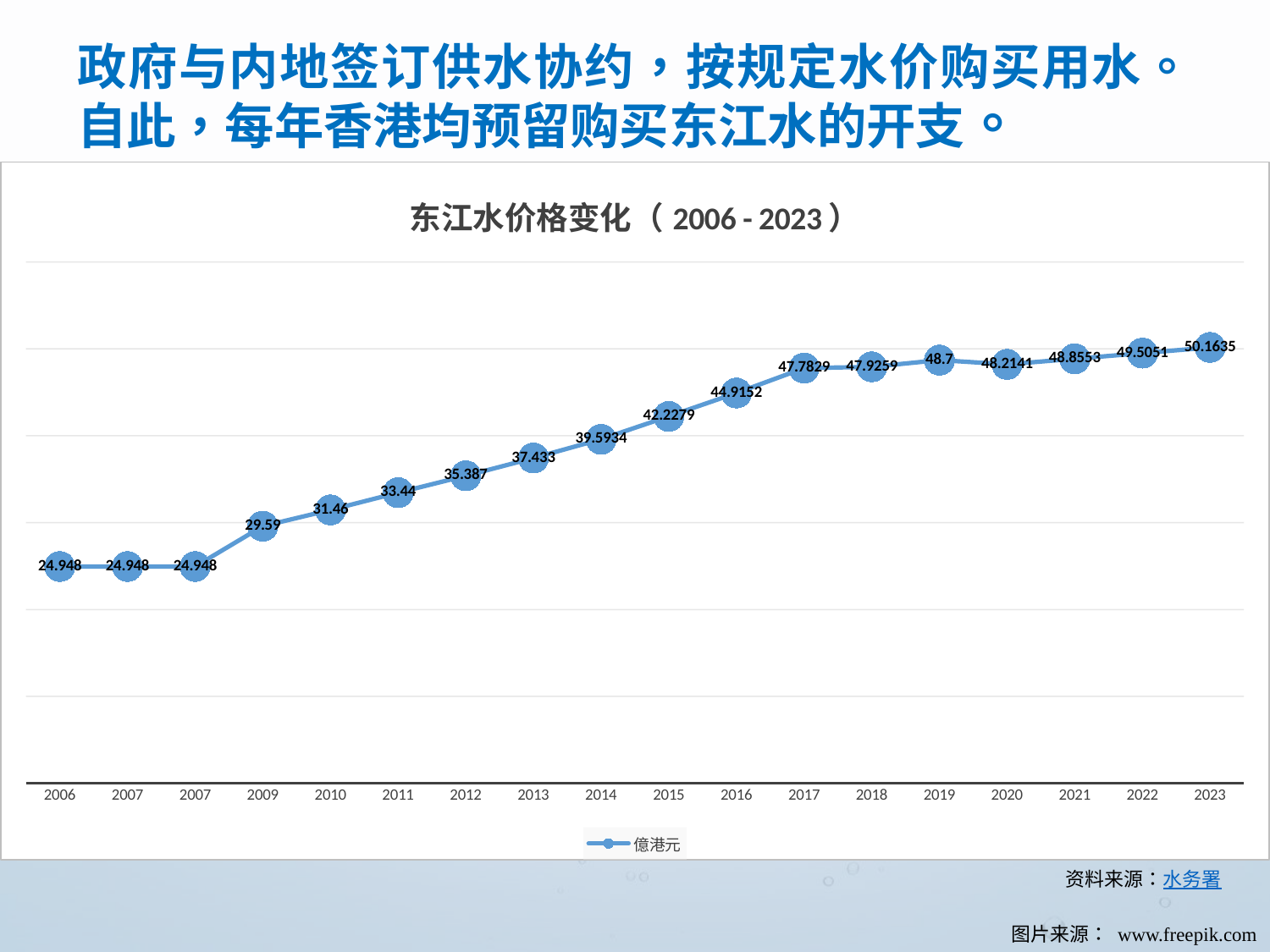
How many series does the legend list? 1 What type of chart is shown on the slide? line chart Do the values generally rise or fall from 2006 to 2023? rise What is the difference between the values for 2023 and 2006? 25.2155 What is the value for 2019? 48.7 What is the value for 2009? 29.59 Which year has the highest value? 2023 How many data points are plotted on the chart? 18 Which is larger, the value for 2019 or the value for 2020? 2019 What is the legend entry for the plotted series? 億港元 What is the value for 2016? 44.9152 What is the value for 2023? 50.1635